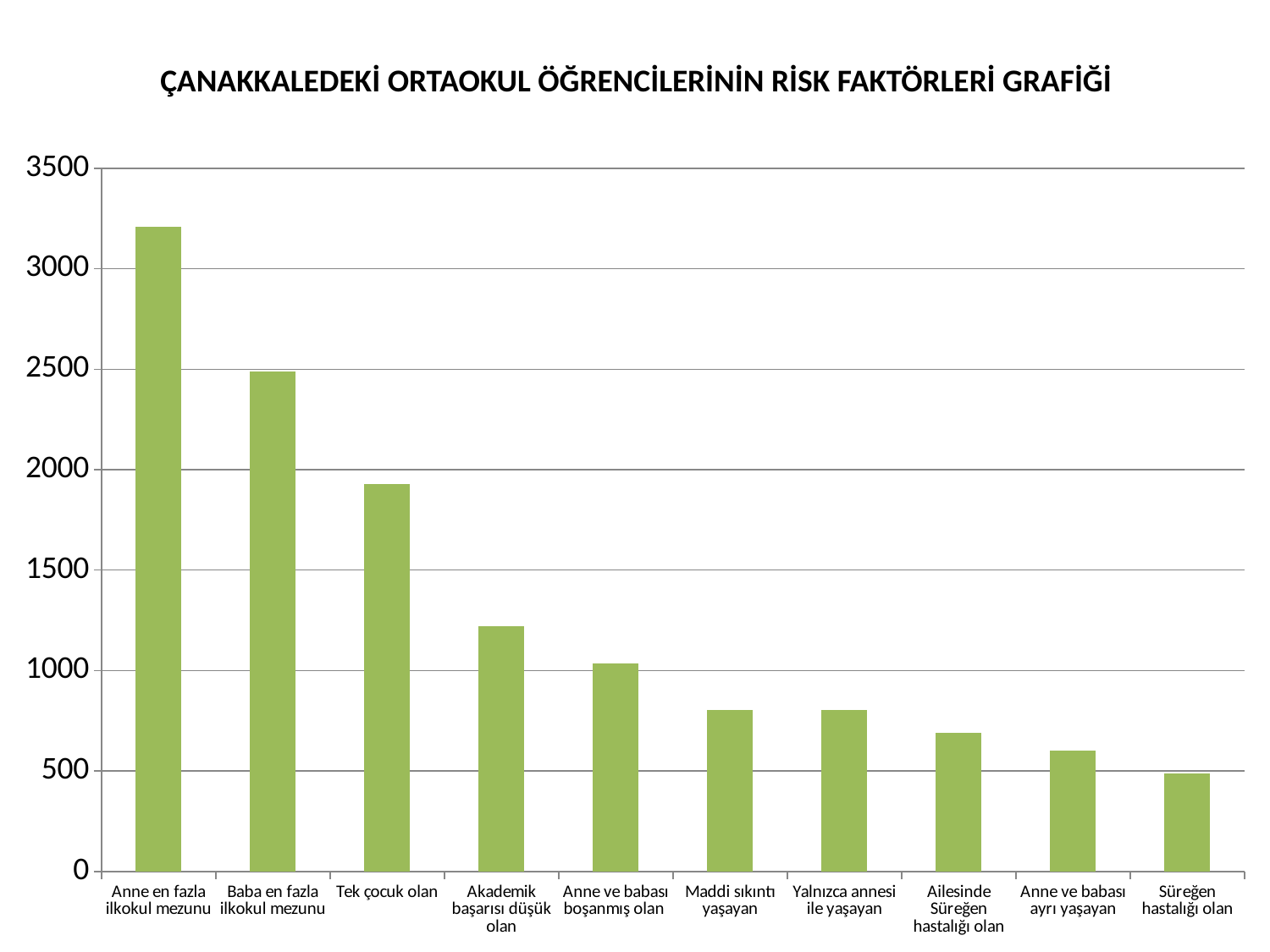
What kind of chart is shown on the slide? bar chart Which is larger, the value for Tek çocuk olan or the value for Akademik başarısı düşük olan? Tek çocuk olan Which category has the lowest value? Süreğen hastalığı olan Do the values rise or fall from left to right along the x axis? fall Which category has the highest value? Anne en fazla ilkokul mezunu Is the value for Anne en fazla ilkokul mezunu greater or less than 3000? greater Is the value for Tek çocuk olan greater or less than 2000? less How many categories are plotted in the chart? 10 What is the title of the chart? ÇANAKKALEDEKİ ORTAOKUL ÖĞRENCİLERİNİN RİSK FAKTÖRLERİ GRAFİĞİ Is the value for Akademik başarısı düşük olan greater or less than 1000? greater